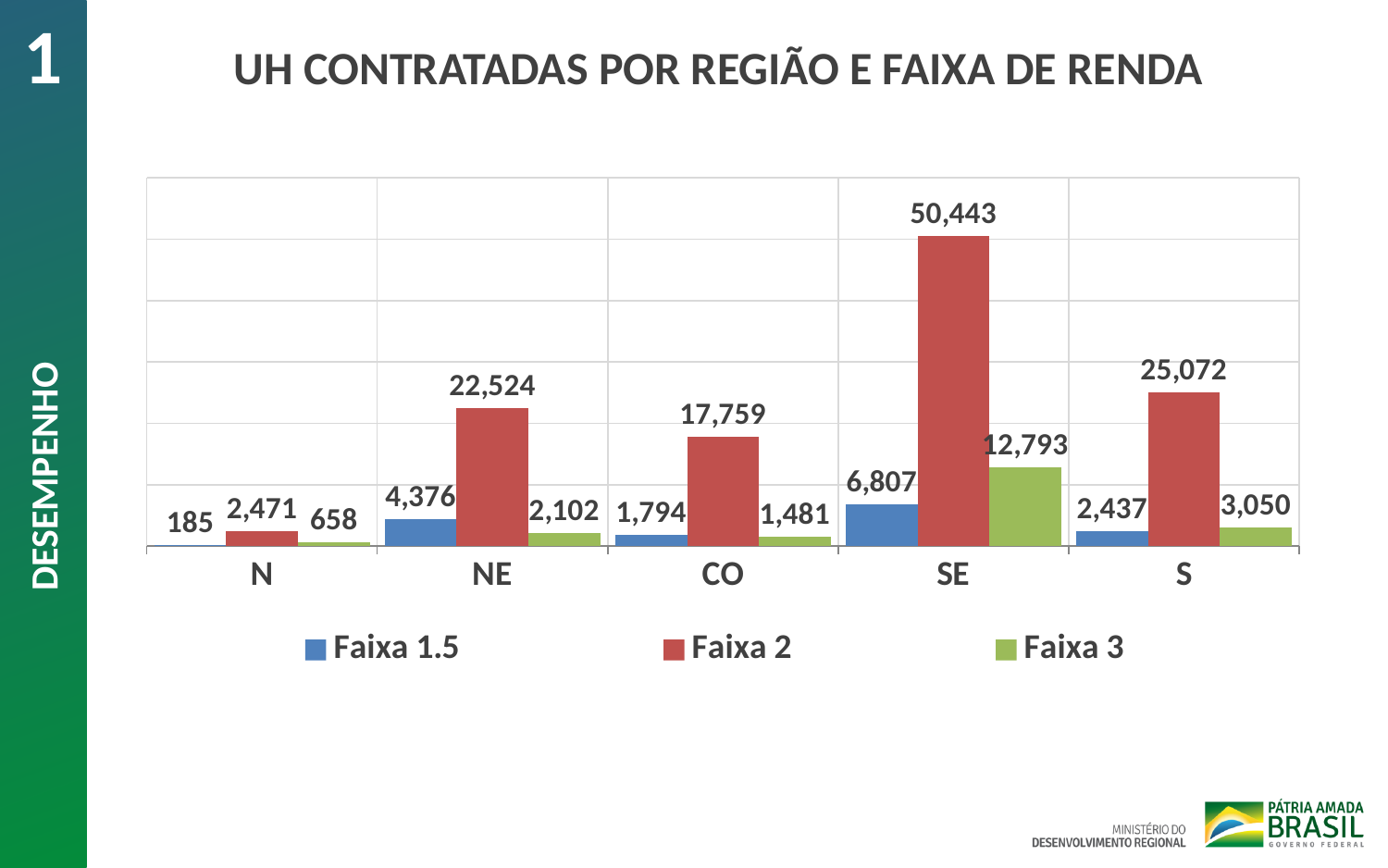
What is the title of the chart? UH CONTRATADAS POR REGIÃO E FAIXA DE RENDA Which region has the highest value for Faixa 2? SE What is the value for Faixa 2 in the CO region? 17,759 How many series does the legend list? 3 What kind of chart is shown on the slide? Bar chart What is the difference between the Faixa 2 values for S and NE? 2,548 What is the value for Faixa 2 in the SE region? 50,443 What is the value for Faixa 1.5 in the N region? 185 Which region has the lowest value for Faixa 1.5? N Which is larger: Faixa 3 in NE or Faixa 3 in CO? Faixa 3 in NE How many regions are shown on the x axis? 5 What is the value for Faixa 3 in the S region? 3,050